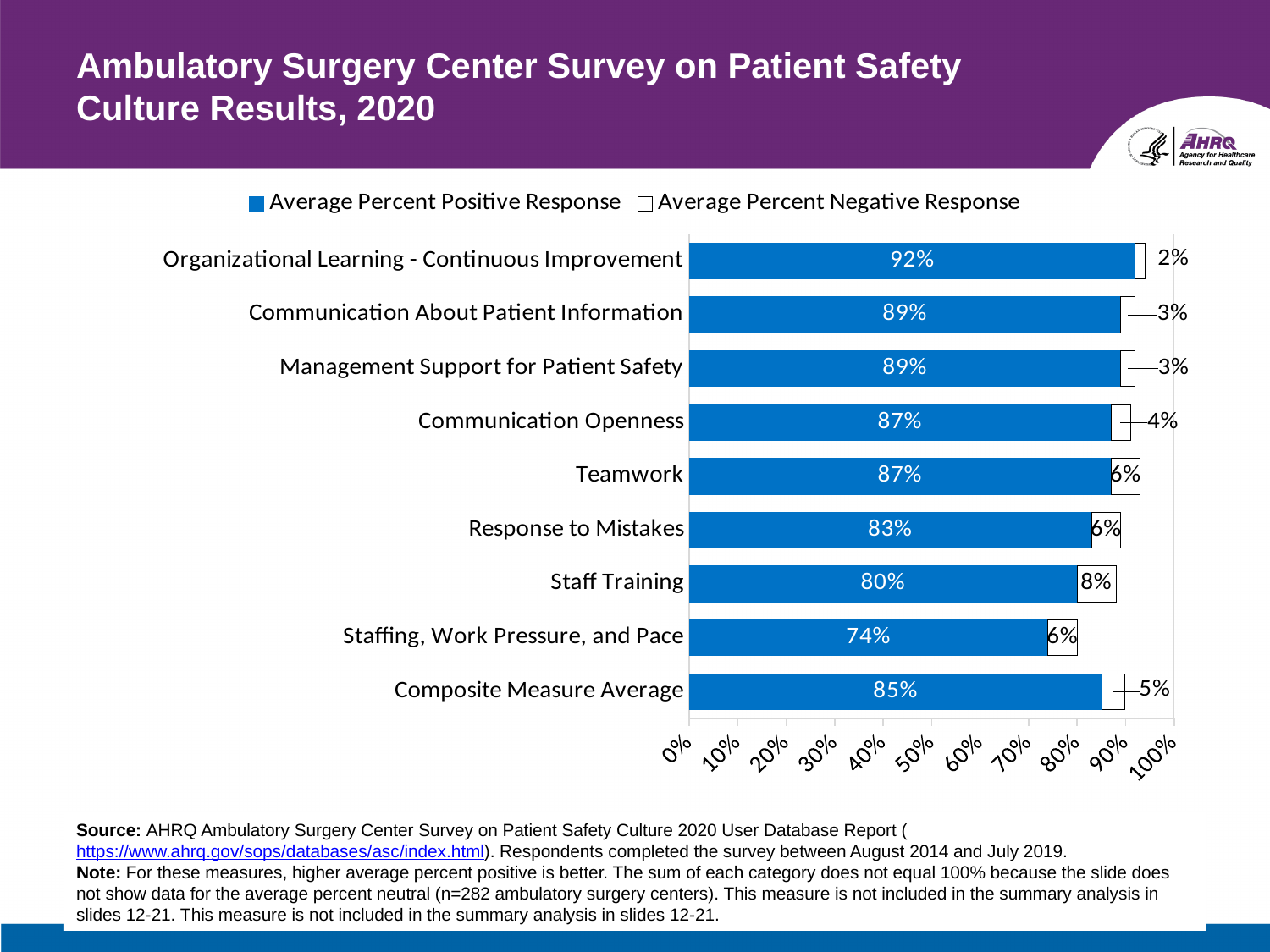
Which category has the highest Average Percent Positive Response? Organizational Learning - Continuous Improvement What is the difference in Average Percent Positive Response between Organizational Learning - Continuous Improvement and Staffing, Work Pressure, and Pace? 18% What is the Average Percent Positive Response for Organizational Learning - Continuous Improvement? 92% Which series is shown in blue in the legend? Average Percent Positive Response How many series does the legend list? 2 How many categories are shown on the chart? 9 What is the Average Percent Negative Response for Staff Training? 8% Which has a higher Average Percent Positive Response, Communication Openness or Staff Training? Communication Openness What is the combined total of the positive and negative response percentages for Staff Training? 88% What is the Average Percent Positive Response for the Composite Measure Average? 85% Which category has the lowest Average Percent Positive Response? Staffing, Work Pressure, and Pace What kind of chart is shown on the slide? Bar chart